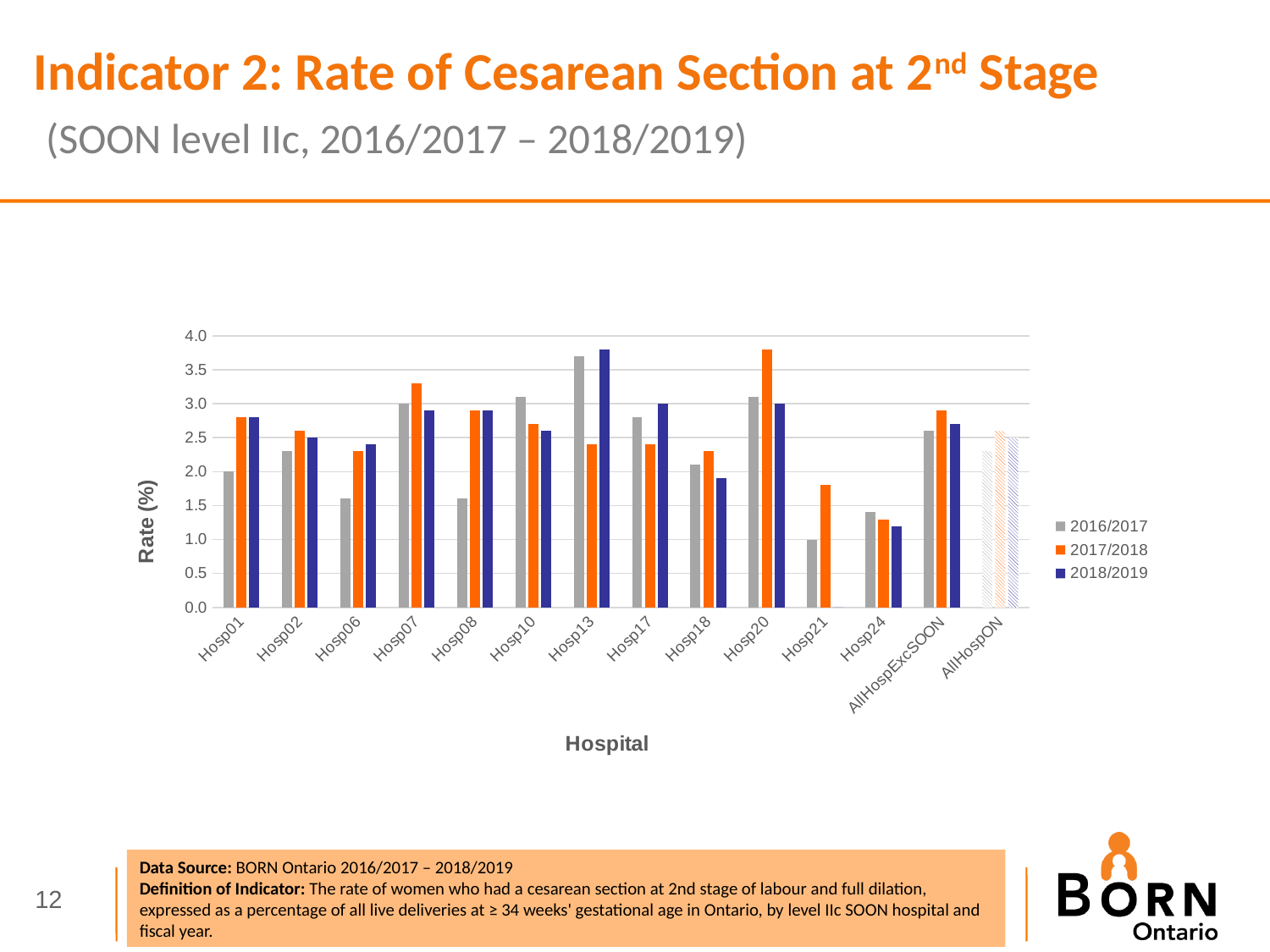
Which hospital has the lowest 2016/2017 rate? Hosp21 Is the 2017/2018 value for Hosp20 greater or less than 3.5? greater Which hospital has the highest 2017/2018 rate? Hosp20 How many series does the legend list? 3 Is the 2016/2017 value for Hosp08 greater or less than 2.0? less Is the 2018/2019 value for Hosp13 greater or less than 3.5? greater Which hospital has no bar for 2018/2019? Hosp21 What is the label of the y axis? Rate (%) What type of chart is shown on the slide? bar chart For Hosp13, which is larger: the 2016/2017 value or the 2017/2018 value? 2016/2017 How many hospital categories are shown on the x axis? 14